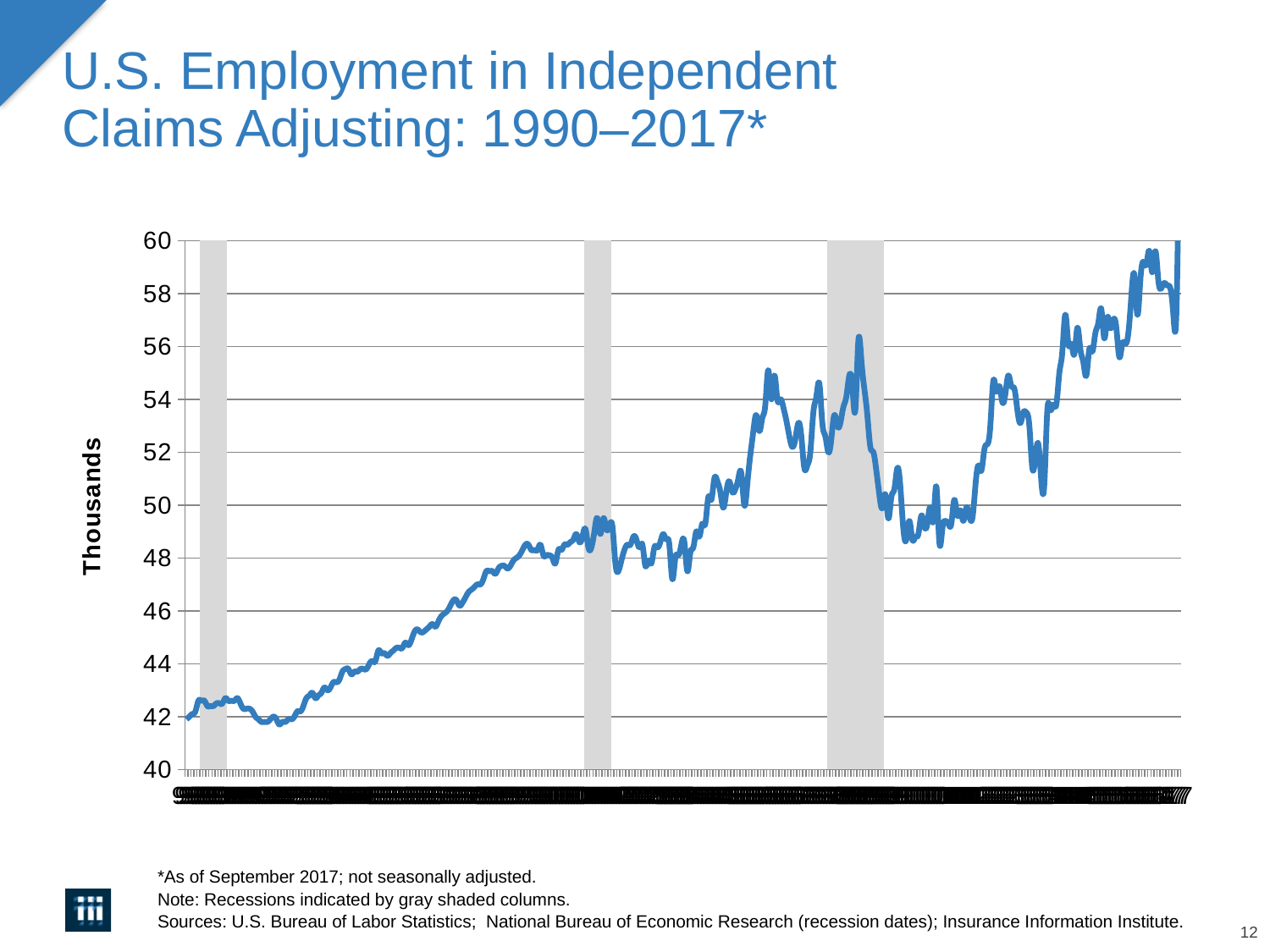
Overall, does the line rise or fall from the left end of the chart to the right end? rise Is the lowest value reached by the line greater or less than 44? less Is the value at the start of the second gray shaded column greater or less than 48? greater What is the label on the vertical axis of the chart? Thousands Which is higher: the value at the left end of the line or the value at the right end of the line? the right end Is the highest value reached by the line greater or less than 58? greater Does the line rise or fall across the third (rightmost) gray shaded column? fall What kind of chart is shown on the slide? line chart How many gray shaded recession columns are shown on the chart? 3